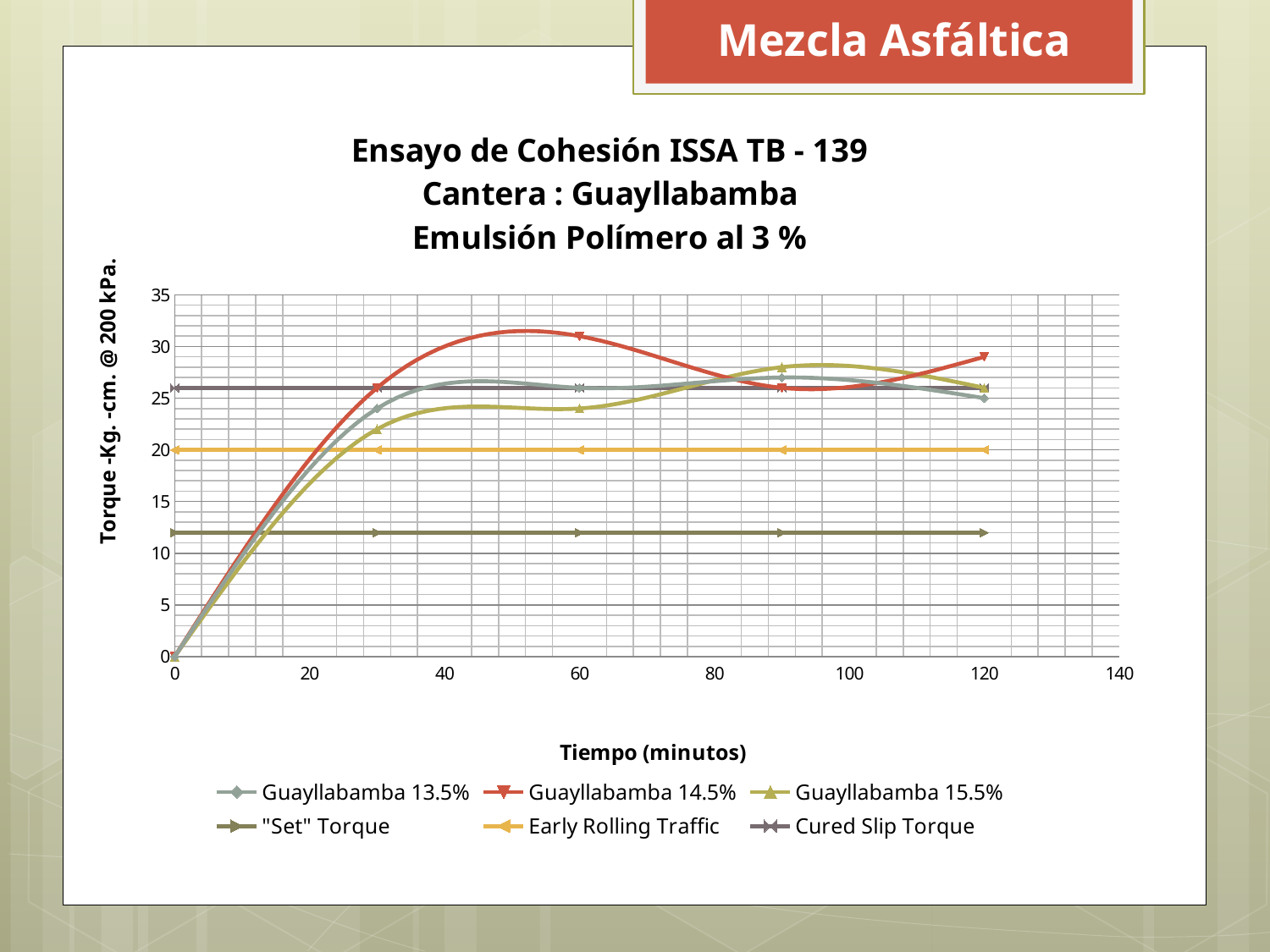
Is the value of the "Set" Torque line greater or less than 15? less What kind of chart is shown on the slide? line chart At 30 minutes, which is larger: Guayllabamba 14.5% or Guayllabamba 15.5%? Guayllabamba 14.5% What is the label of the x axis? Tiempo (minutos) What is the constant value of the Early Rolling Traffic line? 20 What is the label of the y axis? Torque -Kg. -cm. @ 200 kPa. Is the value for Guayllabamba 13.5% at 120 minutes greater or less than 30? less Which series has the highest value at 60 minutes? Guayllabamba 14.5% Among the three Guayllabamba series, which has the lowest value at 60 minutes? Guayllabamba 15.5% How many series does the legend list? 6 Is the value for Guayllabamba 14.5% at 60 minutes greater or less than 30? greater Does the Guayllabamba 15.5% line rise or fall between 0 and 30 minutes? rise